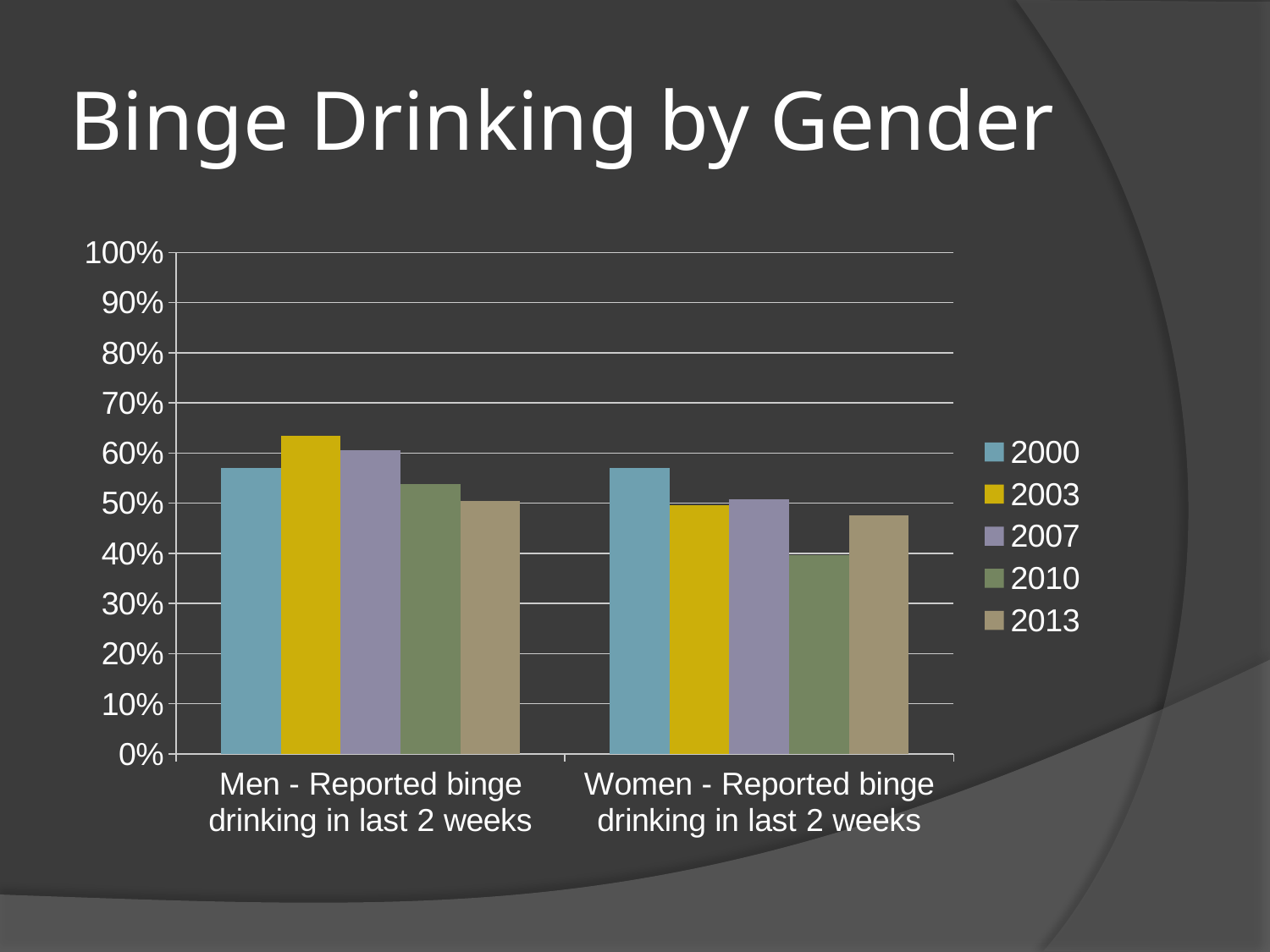
Which year has the lowest value for Women - Reported binge drinking in last 2 weeks? 2010 Is the 2003 value for Men - Reported binge drinking in last 2 weeks greater or less than 60%? greater What kind of chart is shown on the slide? Bar chart Which year has the highest value for Women - Reported binge drinking in last 2 weeks? 2000 How many series does the legend list? 5 Is the 2010 value for Women - Reported binge drinking in last 2 weeks greater or less than 50%? less For 2003, which is larger: the value for Men or the value for Women? Men For 2010, which is larger: the value for Men or the value for Women? Men What is the title of the slide? Binge Drinking by Gender Is the 2013 value for Women - Reported binge drinking in last 2 weeks greater or less than 50%? less How many categories are shown on the x axis? 2 Which year has the highest value for Men - Reported binge drinking in last 2 weeks? 2003